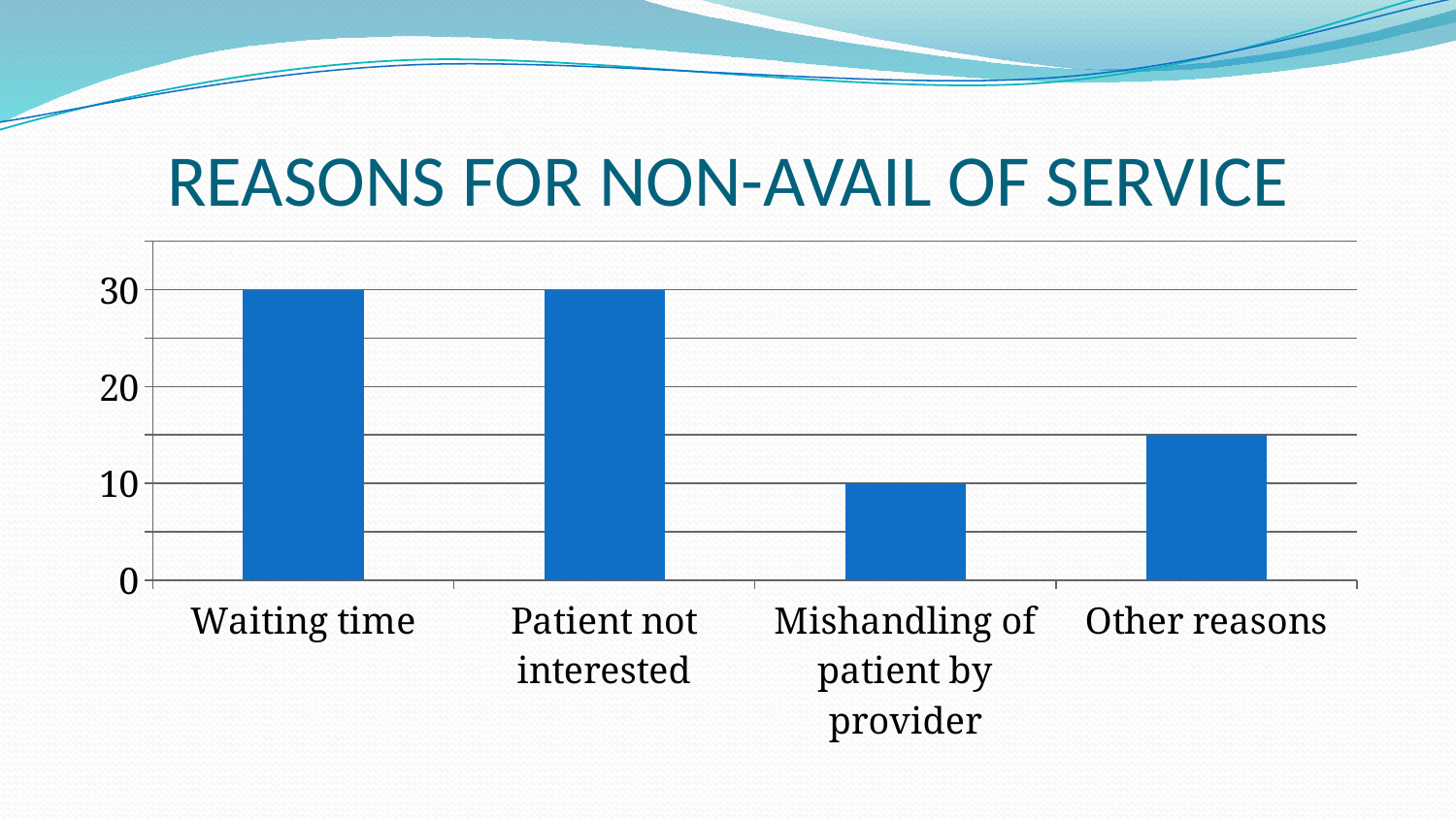
What is the difference between the values for Waiting time and Mishandling of patient by provider? 20 What is the title of the slide? REASONS FOR NON-AVAIL OF SERVICE Is the value for Other reasons greater or less than 20? less Is the value for Other reasons greater or less than 10? greater What is the value for Waiting time? 30 What is the value for Patient not interested? 30 Which category has the lowest value? Mishandling of patient by provider What is the value for Mishandling of patient by provider? 10 Which is larger, the value for Waiting time or the value for Other reasons? Waiting time Which is larger, the value for Other reasons or the value for Mishandling of patient by provider? Other reasons How many categories are shown on the x axis? 4 What kind of chart is shown on the slide? bar chart